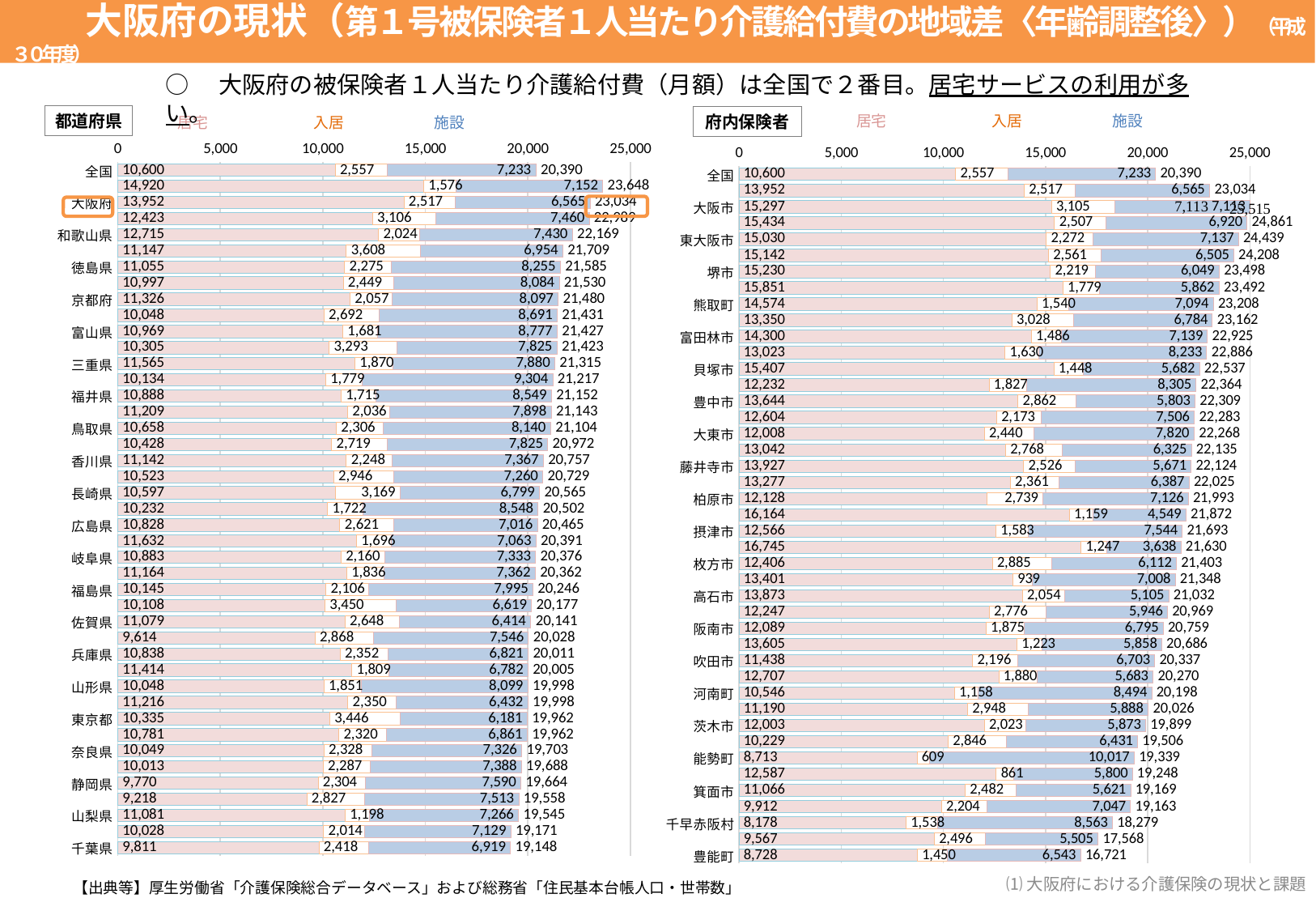
In the left chart (都道府県), is the total for 千葉県 greater or less than 20,000? less In the right chart (府内保険者), which is larger, the 居宅 value for 堺市 or the 居宅 value for 吹田市? 堺市 In the left chart (都道府県), what is the difference between the total for 大阪府 and the total for 全国? 2,644 In the left chart (都道府県), what is the 入居 value for 東京都? 3,446 What kind of chart is the left chart (都道府県)? Stacked horizontal bar chart In the left chart (都道府県), what is the 施設 value for 富山県? 8,777 In the left chart (都道府県), what is the 居宅 value for 大阪府? 13,952 In the right chart (府内保険者), what is the 施設 value for 能勢町? 10,017 In the left chart (都道府県), what is the total shown at the end of the 全国 bar? 20,390 In the right chart (府内保険者), what is the 入居 value for 枚方市? 2,885 How many series does the legend of the right chart (府内保険者) list? 3 In the right chart (府内保険者), what is the total shown for 豊能町? 16,721